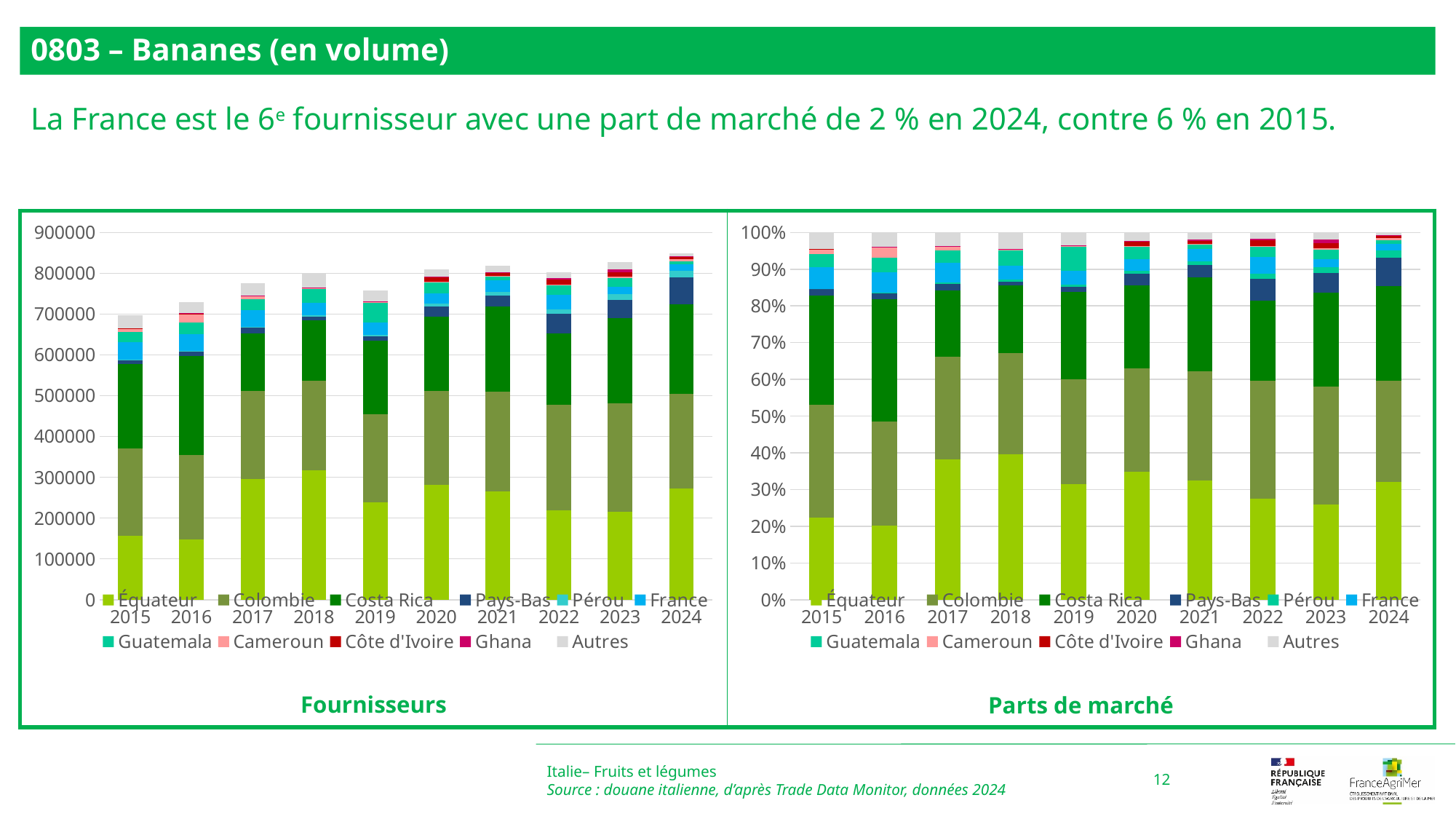
In the 'Fournisseurs' chart, is the Équateur segment larger in 2018 or in 2024? 2018 How many years are shown on the x axis of the 'Parts de marché' chart? 10 In the 'Parts de marché' chart, does the Équateur share rise or fall from 2018 to 2023? fall What is the title shown under the right-hand chart? Parts de marché In the 'Fournisseurs' chart, which year has the lowest total bar? 2015 In the 'Fournisseurs' chart, is the total height of the 2024 bar greater or less than 800000? greater What kind of chart is the 'Fournisseurs' chart on the left? stacked bar chart In the 'Parts de marché' chart, is the Équateur share larger in 2018 or in 2023? 2018 How many series does the legend of the 'Fournisseurs' chart list? 11 In the 'Fournisseurs' chart, is the total height of the 2019 bar greater or less than 800000? less In the 'Parts de marché' chart, is the Équateur share in 2017 greater or less than 30%? greater